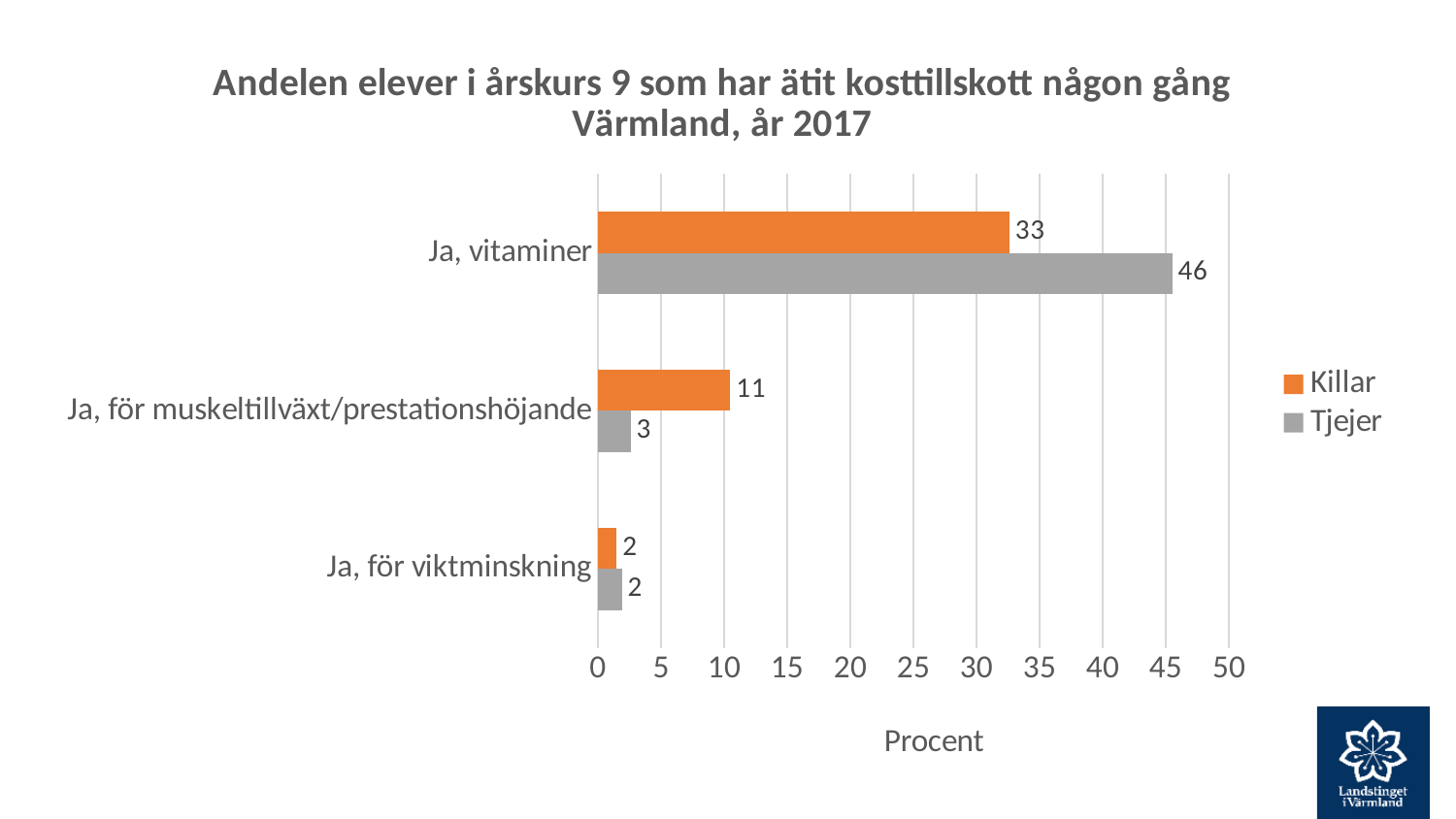
What kind of chart is shown on the slide? Bar chart How many categories are shown on the chart? 3 Which colour represents Killar in the chart? Orange Which series has the larger value in the 'Ja, för muskeltillväxt/prestationshöjande' category, Killar or Tjejer? Killar What is the value for Killar in the 'Ja, vitaminer' category? 33 Which category has the lowest value for Killar? Ja, för viktminskning What is the label of the horizontal axis? Procent Which category has the highest value for Tjejer? Ja, vitaminer How many series does the legend list? 2 What is the difference between Tjejer and Killar in the 'Ja, vitaminer' category? 13 What is the value for Killar in the 'Ja, för muskeltillväxt/prestationshöjande' category? 11 What is the value for Tjejer in the 'Ja, vitaminer' category? 46